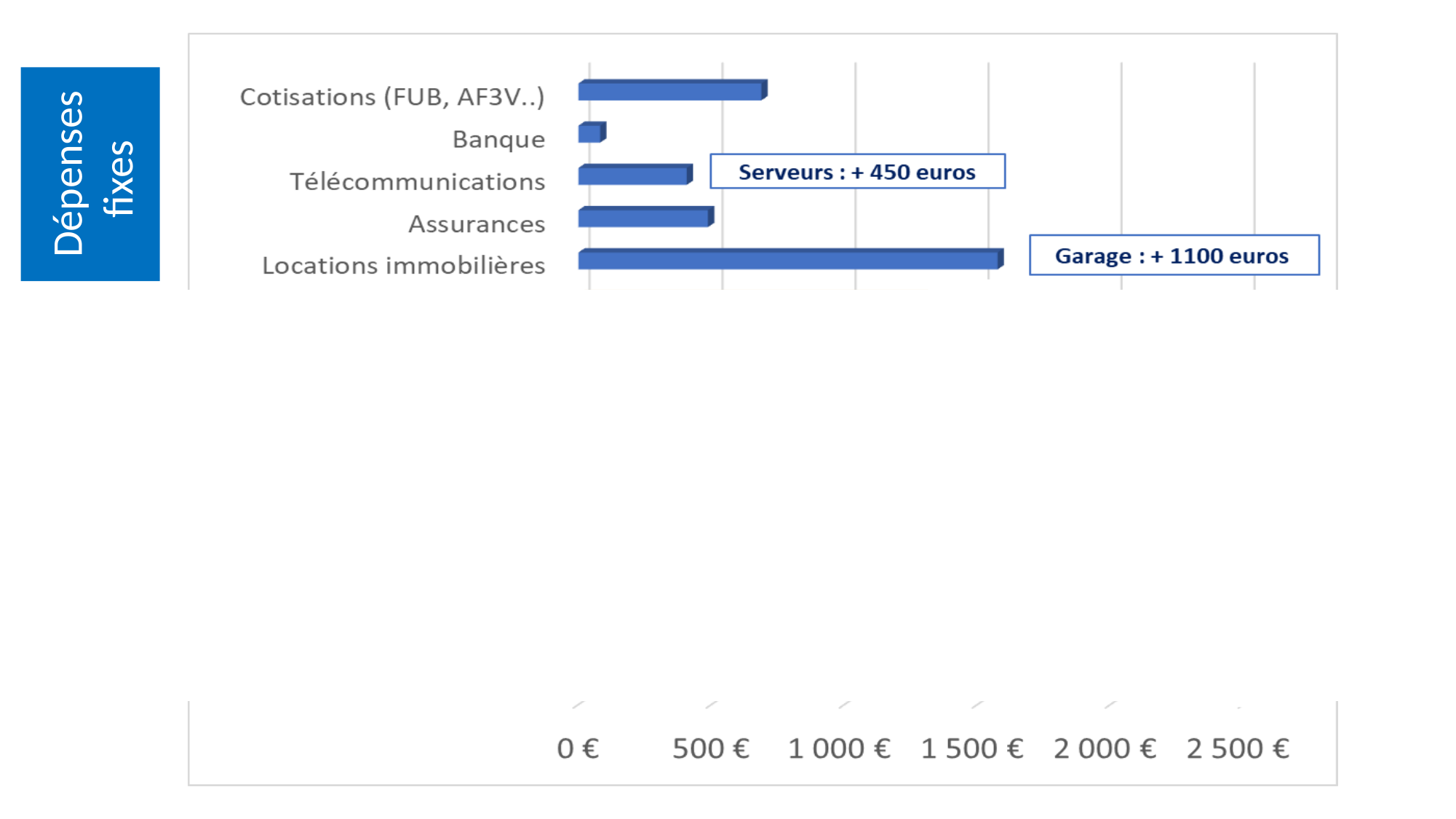
How many categories are plotted in the chart? 5 Which is larger, the value for Cotisations (FUB, AF3V..) or the value for Télécommunications? Cotisations (FUB, AF3V..) What does the annotation next to the Locations immobilières bar say? Garage : + 1100 euros Is the value for Locations immobilières greater or less than 1 500 €? greater Is the value for Locations immobilières greater or less than 2 000 €? less Which category has the highest value in the chart? Locations immobilières What kind of chart is shown on the slide? bar chart Is the value for Télécommunications greater or less than 500 €? less What is the title shown beside the chart? Dépenses fixes Which category has the lowest value in the chart? Banque